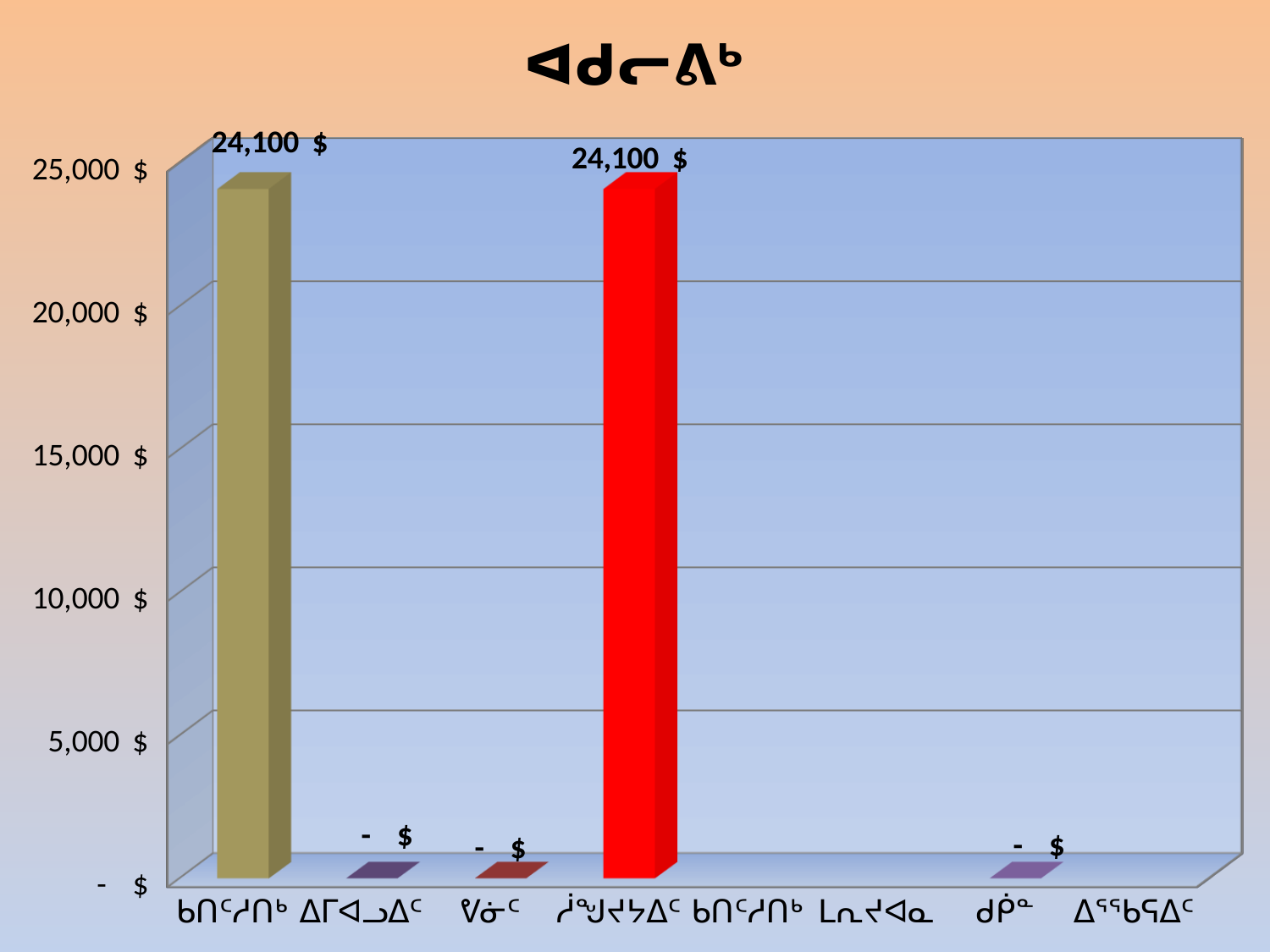
What value is labelled for the second category, ᐃᒥᐊᓗᐃᑦ? - $ What value is labelled on the first (leftmost) bar, ᑲᑎᑦᓱᑎᒃ? 24,100 $ What is the title of the chart? ᐊᑯᓕᕕᒃ What is the highest tick value shown on the vertical axis? 25,000 $ What value is labelled on the red bar for the fourth category, ᓯᖑᔪᔭᐃᑦ? 24,100 $ How many categories are shown along the x axis? 8 What value is labelled for the seventh category, ᑯᑭᓐ? - $ What is the highest value labelled on the chart? 24,100 $ Is the value for the red bar (fourth category) greater or less than 25,000 $? less What kind of chart is shown on the slide? bar chart How many bars carry a data label on the chart? 5 Is the value for the first (leftmost) bar greater or less than 20,000 $? greater